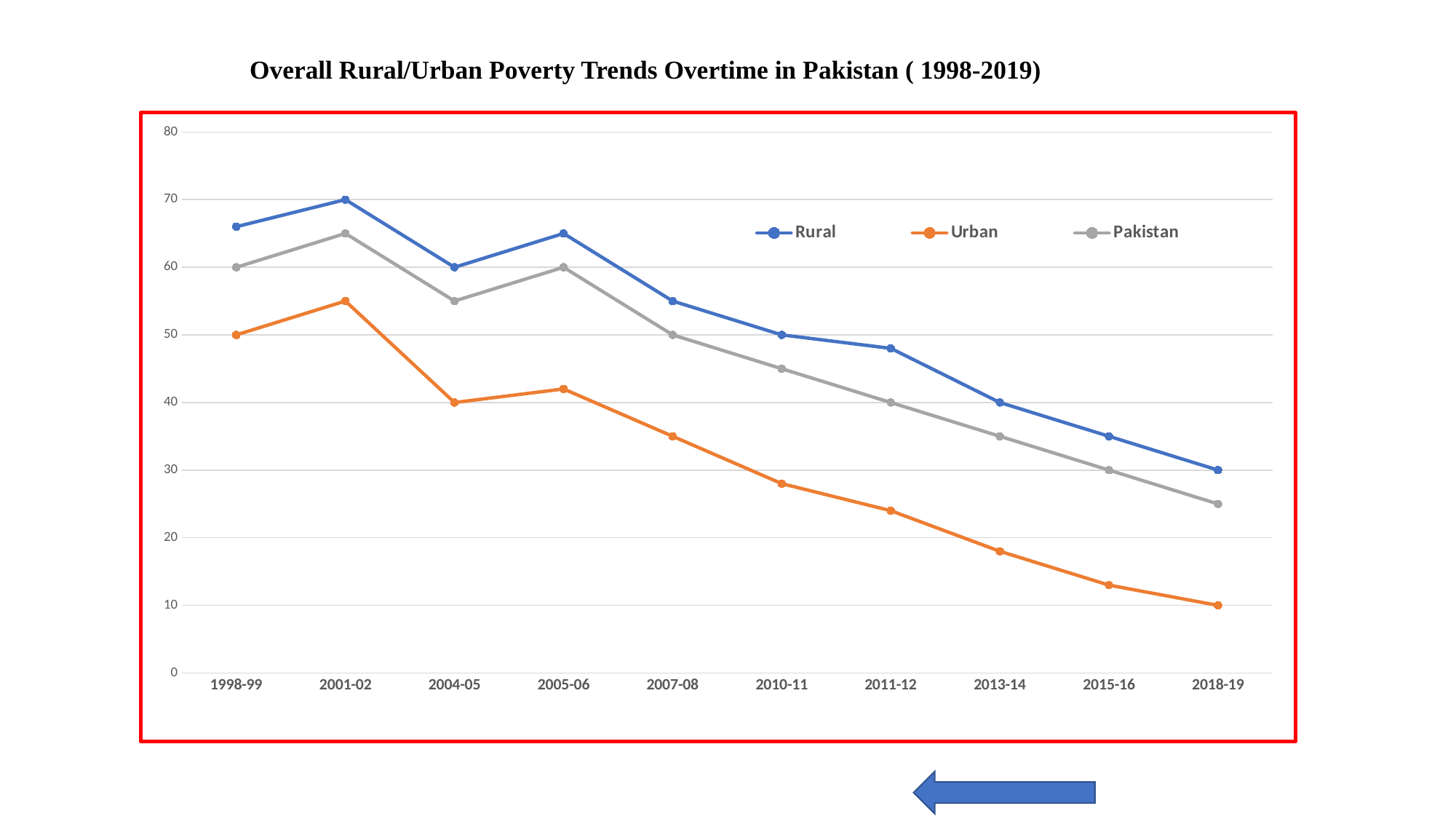
What is the Pakistan value for 2015-16? 30 In which period is the Rural series at its highest? 2001-02 What is the Urban value for 2018-19? 10 How many time periods are shown on the x axis? 10 What is the title of the chart? Overall Rural/Urban Poverty Trends Overtime in Pakistan ( 1998-2019) What is the difference between the Rural and Urban values in 2018-19? 20 In which period is the Urban series at its lowest? 2018-19 How many series does the legend list? 3 Is the Urban value for 2013-14 greater or less than 20? less What kind of chart is shown on the slide? line chart What is the Rural value for 2001-02? 70 Does the Urban series generally rise or fall from 2001-02 to 2018-19? fall